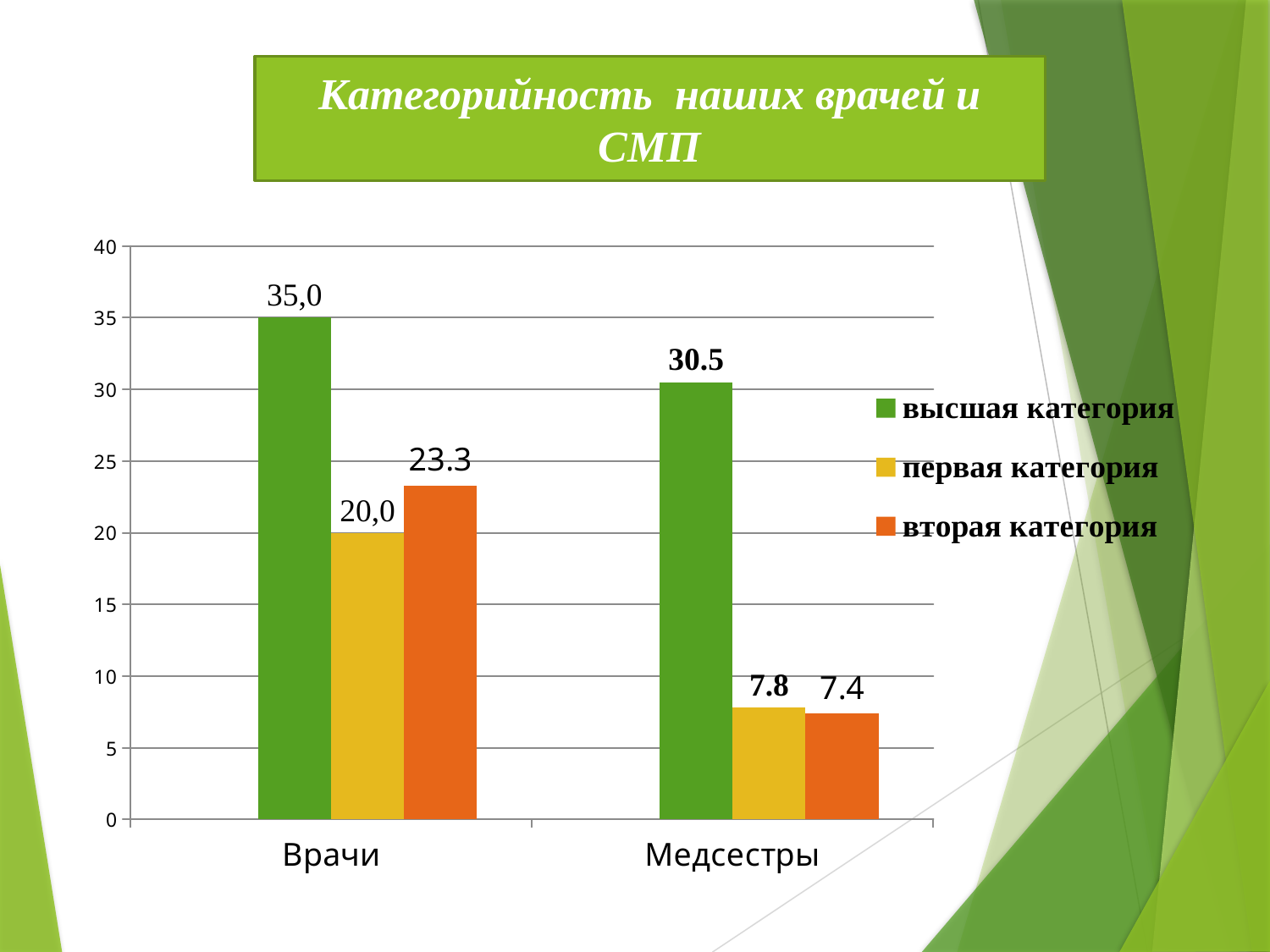
What is the difference between высшая категория and первая категория for Медсестры? 22.7 What is the value for высшая категория for Медсестры? 30.5 How many series does the legend list? 3 Which series has the lowest value for Врачи? первая категория What is the value for вторая категория for Врачи? 23.3 What is the title of the slide? Категорийность наших врачей и СМП How many categories are shown on the x axis? 2 Which is larger for Медсестры: первая категория or вторая категория? первая категория What is the value for высшая категория for Врачи? 35,0 What is the value for первая категория for Медсестры? 7.8 What kind of chart is shown on the slide? bar chart Which series has the highest value for Медсестры? высшая категория